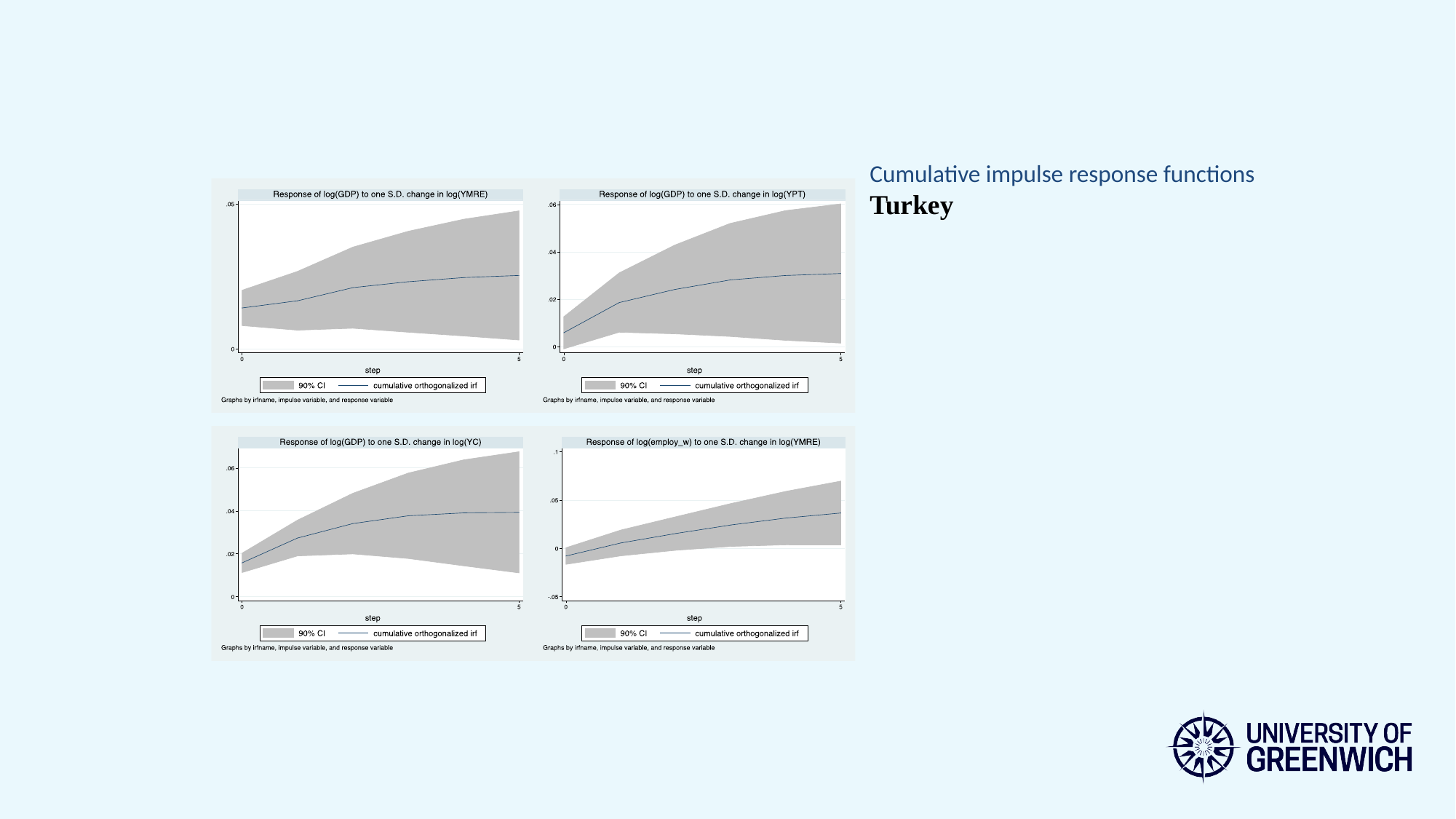
In the top-right chart (response of log(GDP) to log(YPT)), is the cumulative orthogonalized irf at step 0 greater or less than .02? less What are the two legend entries shown under the bottom-right chart? 90% CI and cumulative orthogonalized irf In the bottom-left chart (response of log(GDP) to log(YC)), does the cumulative orthogonalized irf rise or fall along the step axis? rise What is the x-axis label on the bottom-left chart? step In the top-right chart (response of log(GDP) to log(YPT)), is the cumulative orthogonalized irf at step 5 greater or less than .02? greater How many charts are shown on the slide? 4 In the bottom-left chart (response of log(GDP) to log(YC)), is the cumulative orthogonalized irf at step 5 greater or less than .02? greater How many entries does the legend of the top-left chart list? 2 What kind of chart is the top-left chart, 'Response of log(GDP) to one S.D. change in log(YMRE)'? line chart In the top-left chart (response of log(GDP) to log(YMRE)), does the cumulative orthogonalized irf rise or fall as step increases from 0 to 5? rise